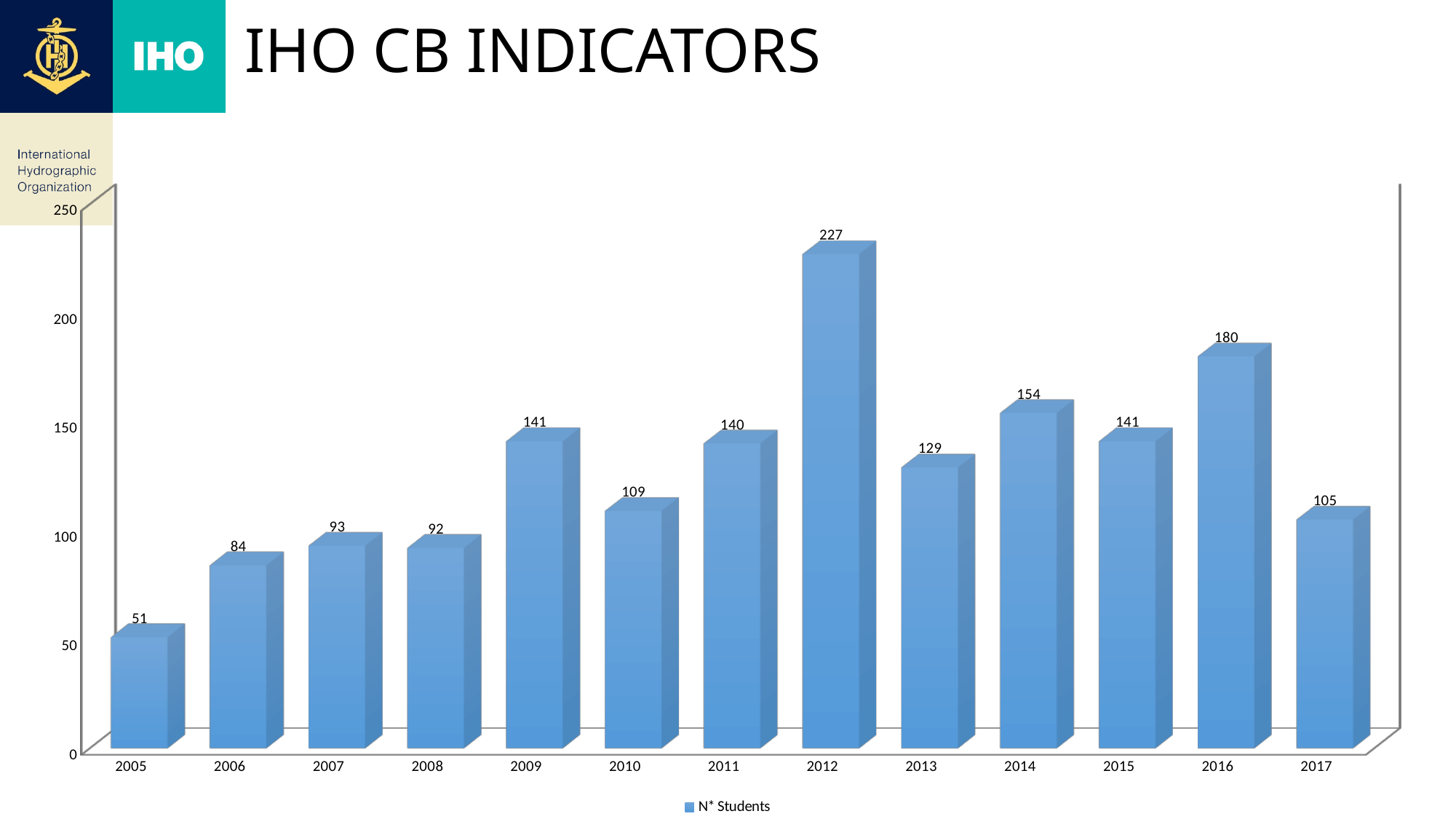
Which is larger, the value for 2014 or the value for 2013? 2014 How many years are shown on the x axis? 13 What is the legend entry for the series? N* Students What kind of chart is shown? bar chart Is the value for 2010 greater or less than 100? greater How many series does the legend list? 1 What is the value for 2005? 51 What is the value for 2012? 227 What is the value for 2017? 105 What is the difference between the values for 2012 and 2016? 47 Which year has the highest value? 2012 Which year has the lowest value? 2005